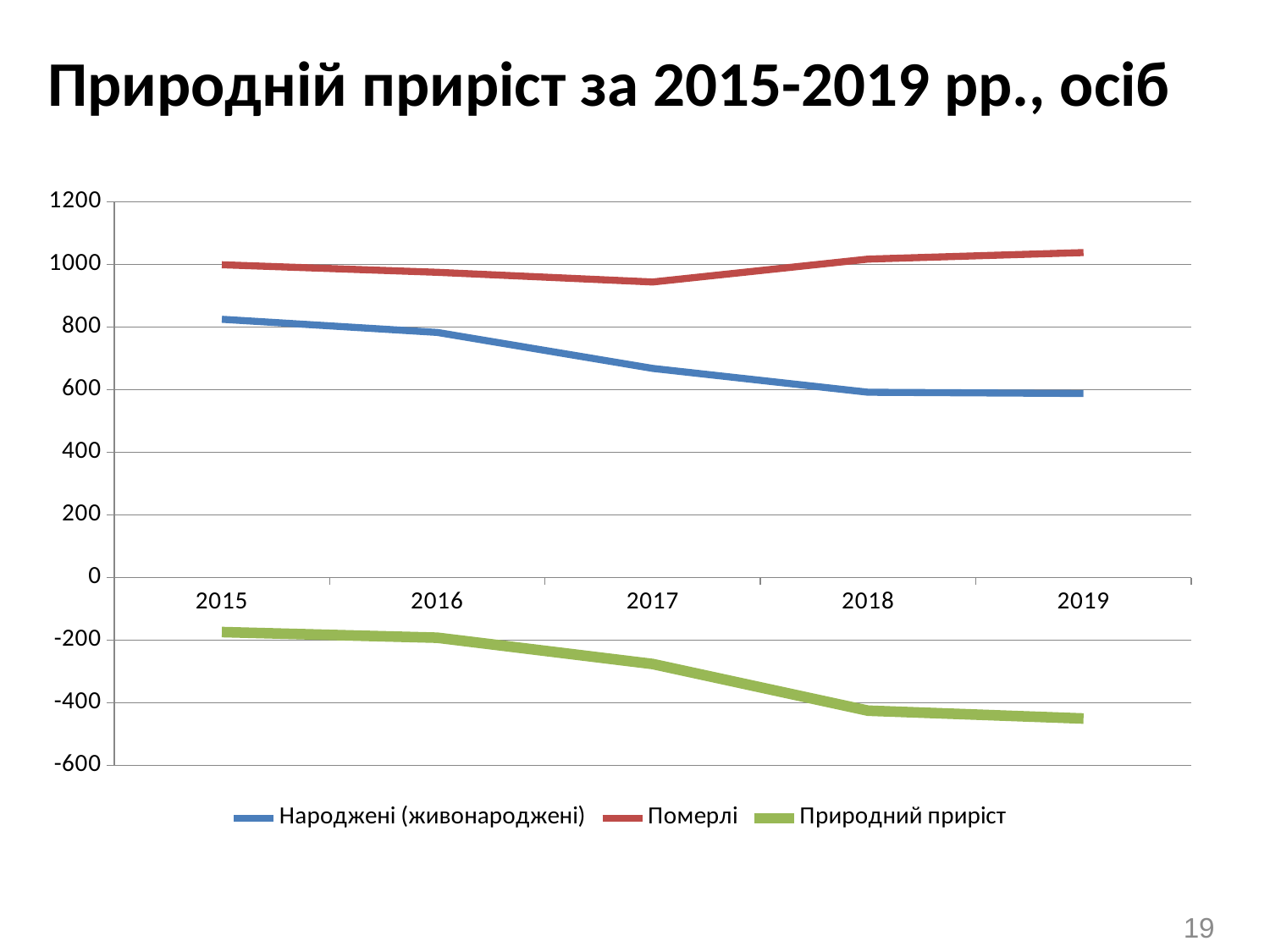
Does the Народжені (живонароджені) line rise or fall from 2015 to 2019? fall Is the value for Померлі in 2017 greater or less than 1000? less What colour is the Природний приріст line? green Is the value for Природний приріст in 2018 greater or less than -400? less Is the value for Народжені (живонароджені) in 2015 greater or less than 800? greater How many years are plotted along the x axis? 5 In which year is the Померлі value lowest? 2017 In which year is the Народжені (живонароджені) value highest? 2015 In 2015, which is larger: Померлі or Народжені (живонароджені)? Померлі What kind of chart is shown on the slide? line chart How many series does the legend list? 3